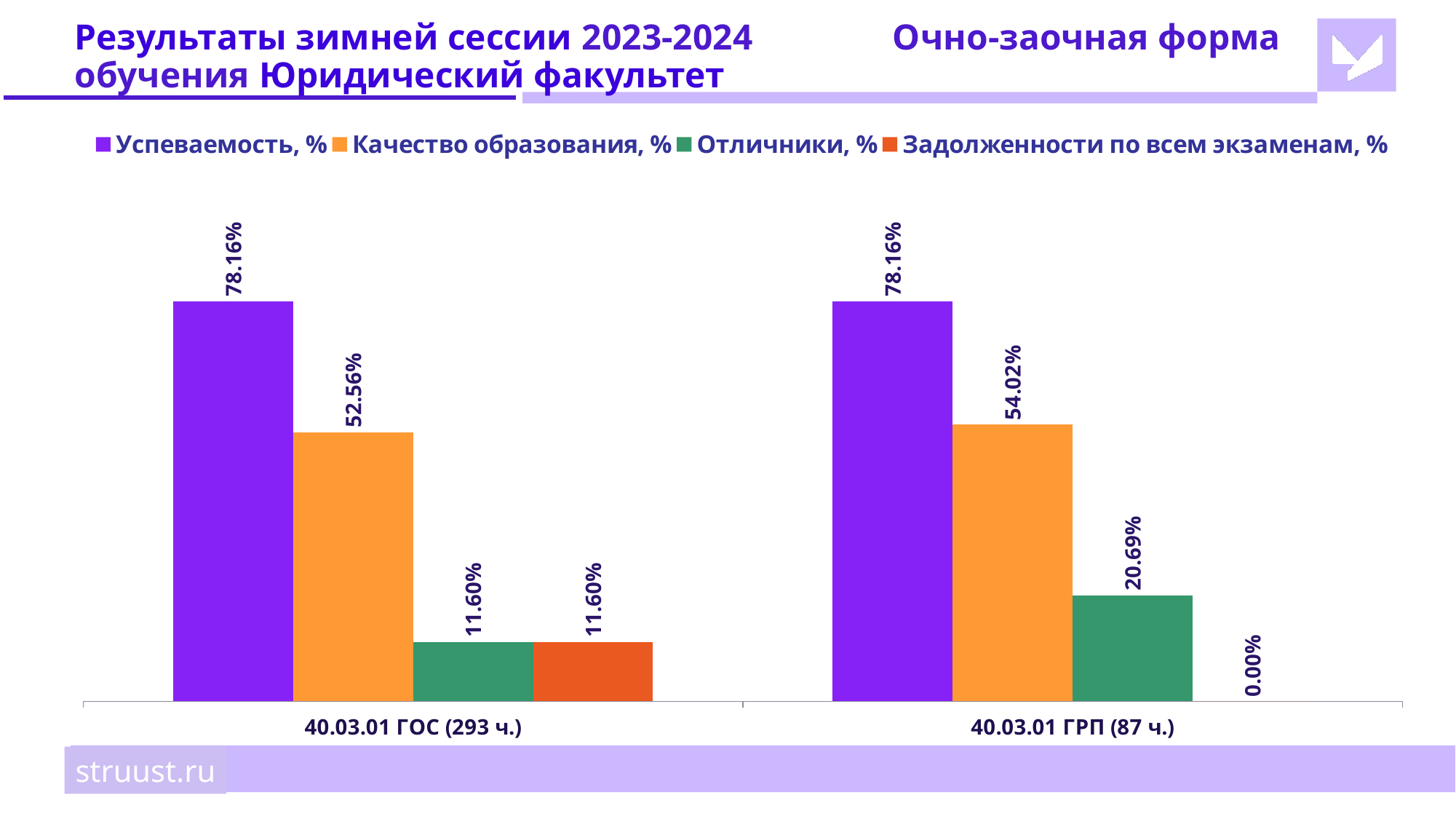
What is the difference between Качество образования, % for 40.03.01 ГРП (87 ч.) and for 40.03.01 ГОС (293 ч.)? 1.46% How many categories are shown on the x axis? 2 What is the difference between Отличники, % for 40.03.01 ГРП (87 ч.) and for 40.03.01 ГОС (293 ч.)? 9.09% What is the value of Качество образования, % for 40.03.01 ГРП (87 ч.)? 54.02% Which category has the higher value for Отличники, %? 40.03.01 ГРП (87 ч.) What is the value of Отличники, % for 40.03.01 ГОС (293 ч.)? 11.60% How many series does the legend list? 4 What is the value of Успеваемость, % for 40.03.01 ГОС (293 ч.)? 78.16% What is the value of Задолженности по всем экзаменам, % for 40.03.01 ГРП (87 ч.)? 0.00% Which series has the lowest value for 40.03.01 ГРП (87 ч.)? Задолженности по всем экзаменам, % What kind of chart is shown on the slide? Bar chart Which is larger: Качество образования, % for 40.03.01 ГОС (293 ч.) or for 40.03.01 ГРП (87 ч.)? 40.03.01 ГРП (87 ч.)